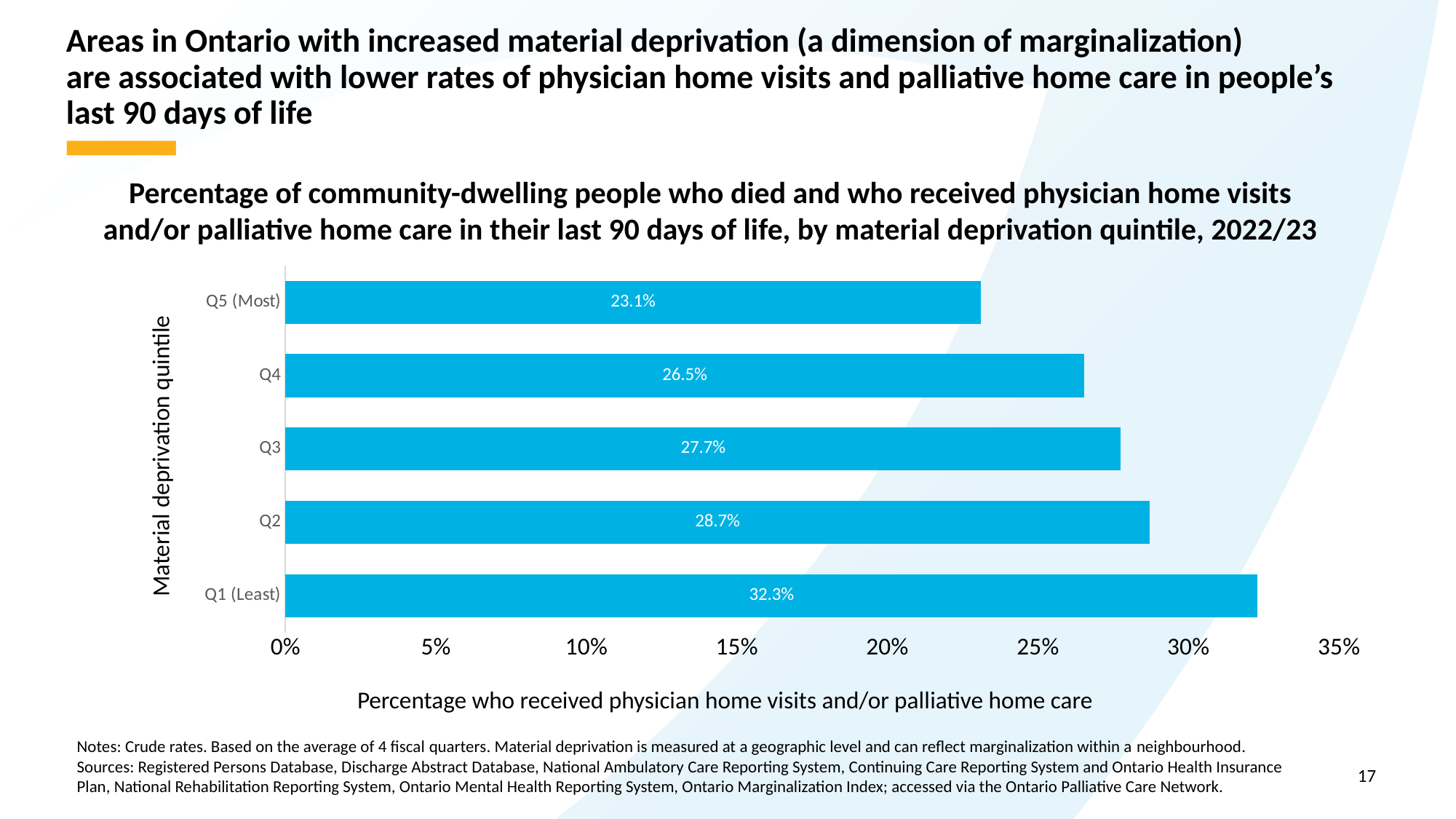
What is the value for Q1 (Least)? 32.3% What is the value for Q3? 27.7% What is the label of the horizontal axis of the chart? Percentage who received physician home visits and/or palliative home care What kind of chart is shown on the slide? Bar chart Which is larger, the value for Q2 or the value for Q3? Q2 What is the difference between the values for Q1 (Least) and Q5 (Most)? 9.2% Is the value for Q4 greater or less than 25%? greater Which quintile has the lowest percentage? Q5 (Most) How many material deprivation quintiles are shown in the chart? 5 Which quintile has the highest percentage? Q1 (Least) What is the difference between the values for Q2 and Q4? 2.2% What is the value for Q5 (Most)? 23.1%